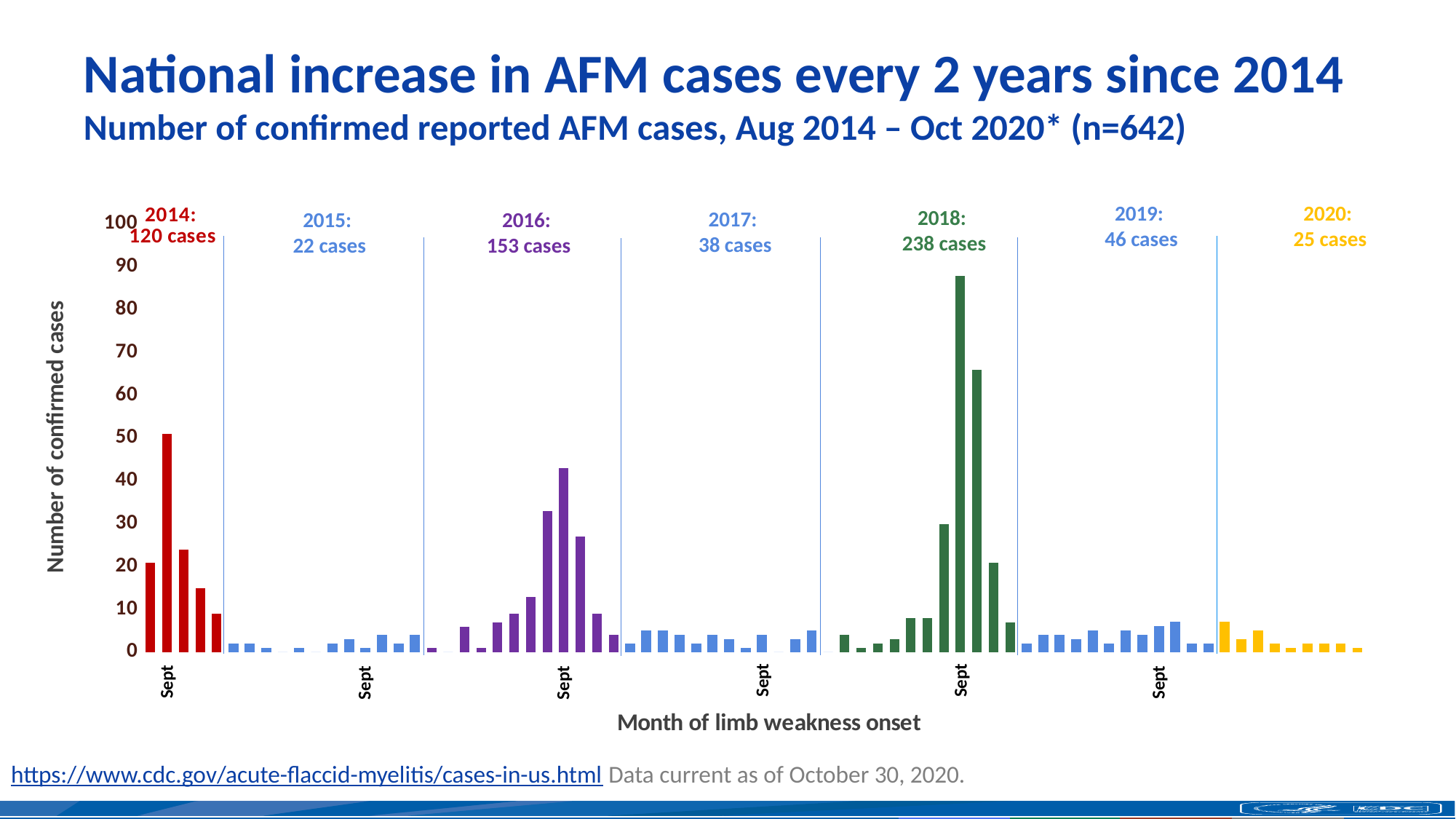
What is the label of the vertical axis of the chart? Number of confirmed cases How many confirmed AFM cases does the chart annotate for 2016? 153 cases How many confirmed AFM cases does the chart annotate for 2018? 238 cases Which year has the lowest annotated number of confirmed AFM cases? 2015 Is the value of the tallest bar in 2014 (September) greater or less than 60? less What is the difference between the annotated case counts for 2018 and 2016? 85 cases Which year has more annotated cases, 2019 or 2020? 2019 What is the difference between the annotated case counts for 2014 and 2017? 82 cases What kind of chart is shown on the slide? Bar chart Is the value of the tallest bar in 2018 (September) greater or less than 80? greater Which year has the highest annotated number of confirmed AFM cases? 2018 How many confirmed AFM cases does the chart annotate for 2015? 22 cases